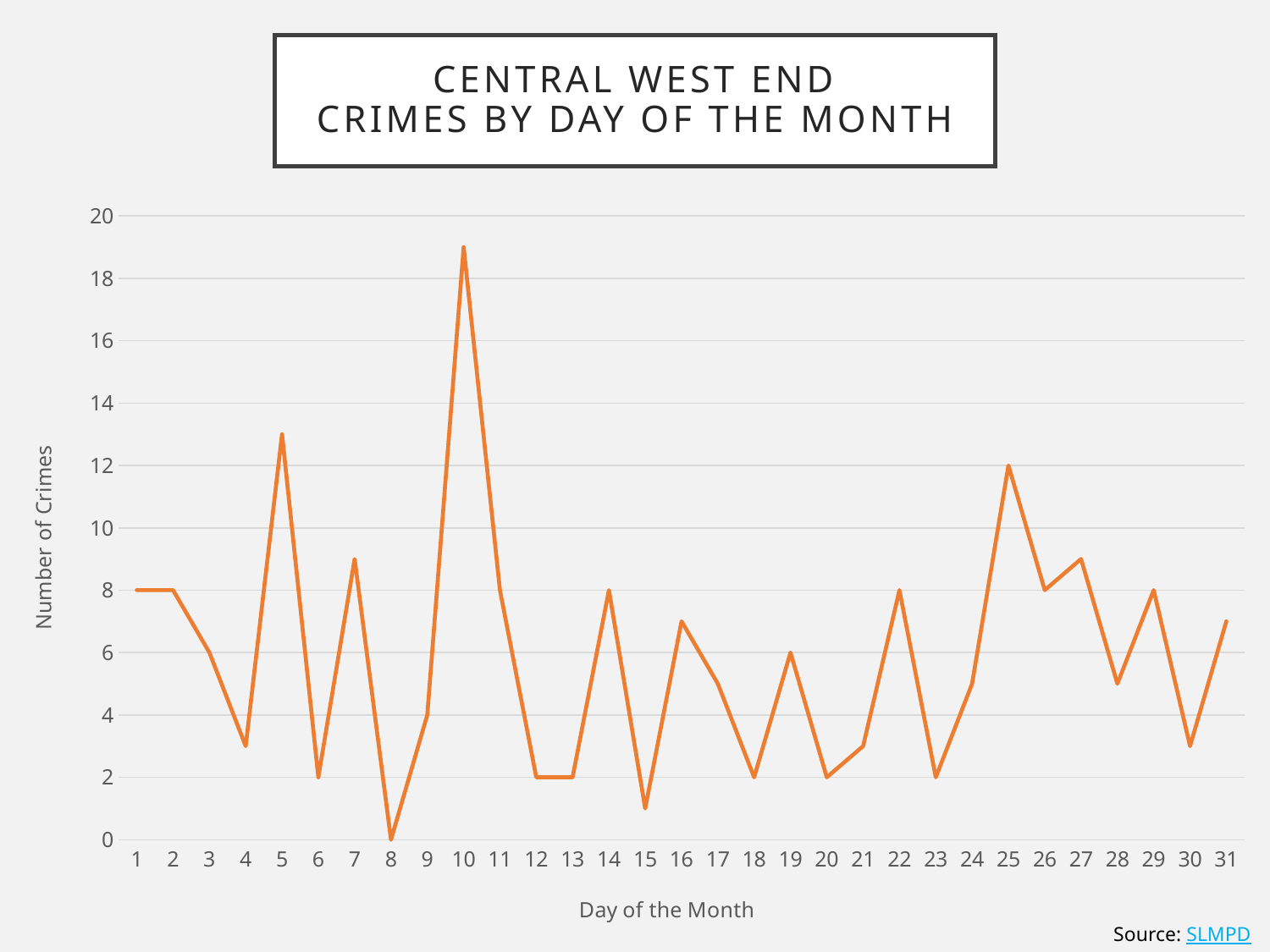
Which day has more crimes, day 5 or day 14? 5 How many days of the month are plotted on the x axis? 31 What kind of chart is shown on the slide? line chart What is the number of crimes on day 25? 12 Is the number of crimes on day 10 greater or less than 18? greater Is the number of crimes on day 15 greater or less than 2? less What is the number of crimes on day 1? 8 Does the number of crimes rise or fall from day 1 to day 4? fall What is the difference in the number of crimes between day 25 and day 26? 4 On which day of the month is the number of crimes highest? 10 On which day of the month is the number of crimes lowest? 8 What is the number of crimes on day 8? 0